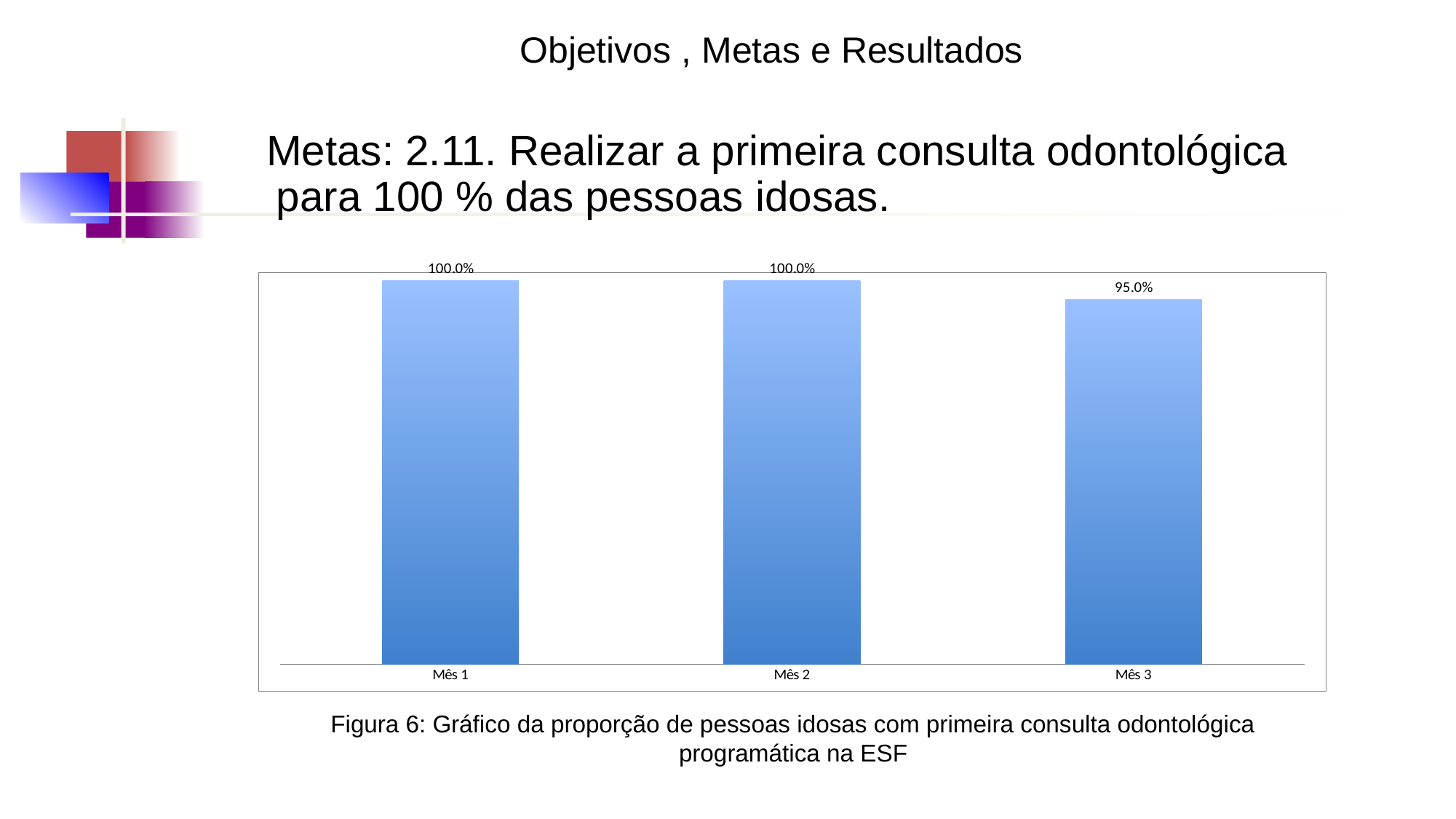
What is the value for Mês 2? 100.0% What is the difference between the values for Mês 1 and Mês 3? 5.0% What colour are the bars in the chart? Blue What figure number is given in the caption below the chart? Figura 6 What is the value for Mês 1? 100.0% What kind of chart is shown on the slide? Bar chart What is the value for Mês 3? 95.0% Which month has the lowest value? Mês 3 How many categories are shown on the x axis? 3 Do the values rise or fall from Mês 2 to Mês 3? Fall Are the values for Mês 1 and Mês 2 equal? Yes Which is larger, the value for Mês 2 or the value for Mês 3? Mês 2